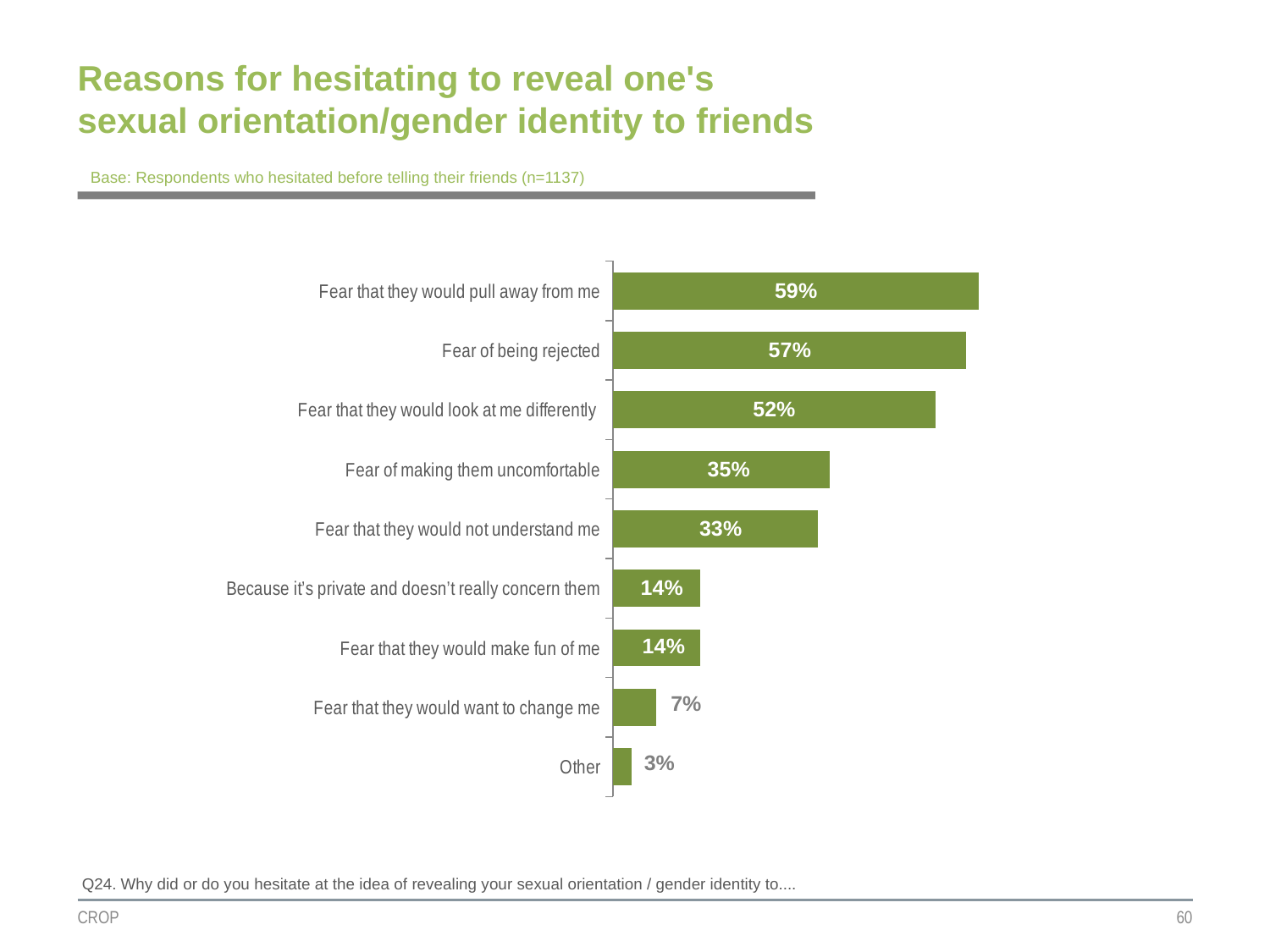
What percentage is shown for "Fear that they would want to change me"? 7% What percentage of respondents cited "Fear that they would pull away from me"? 59% What is the difference between "Fear that they would not understand me" and "Fear that they would make fun of me"? 19% What is the base sample size (n) stated for the chart? n=1137 Which reason has the highest percentage? Fear that they would pull away from me Which two categories share the same value of 14%? Because it's private and doesn't really concern them; Fear that they would make fun of me What is the difference between "Fear of being rejected" and "Fear that they would look at me differently"? 5% What is the value for "Fear of making them uncomfortable"? 35% Which is larger: "Fear of making them uncomfortable" or "Fear that they would not understand me"? Fear of making them uncomfortable How many reasons (categories) are shown in the chart? 9 Which category has the lowest percentage? Other What kind of chart is shown on the slide? Bar chart